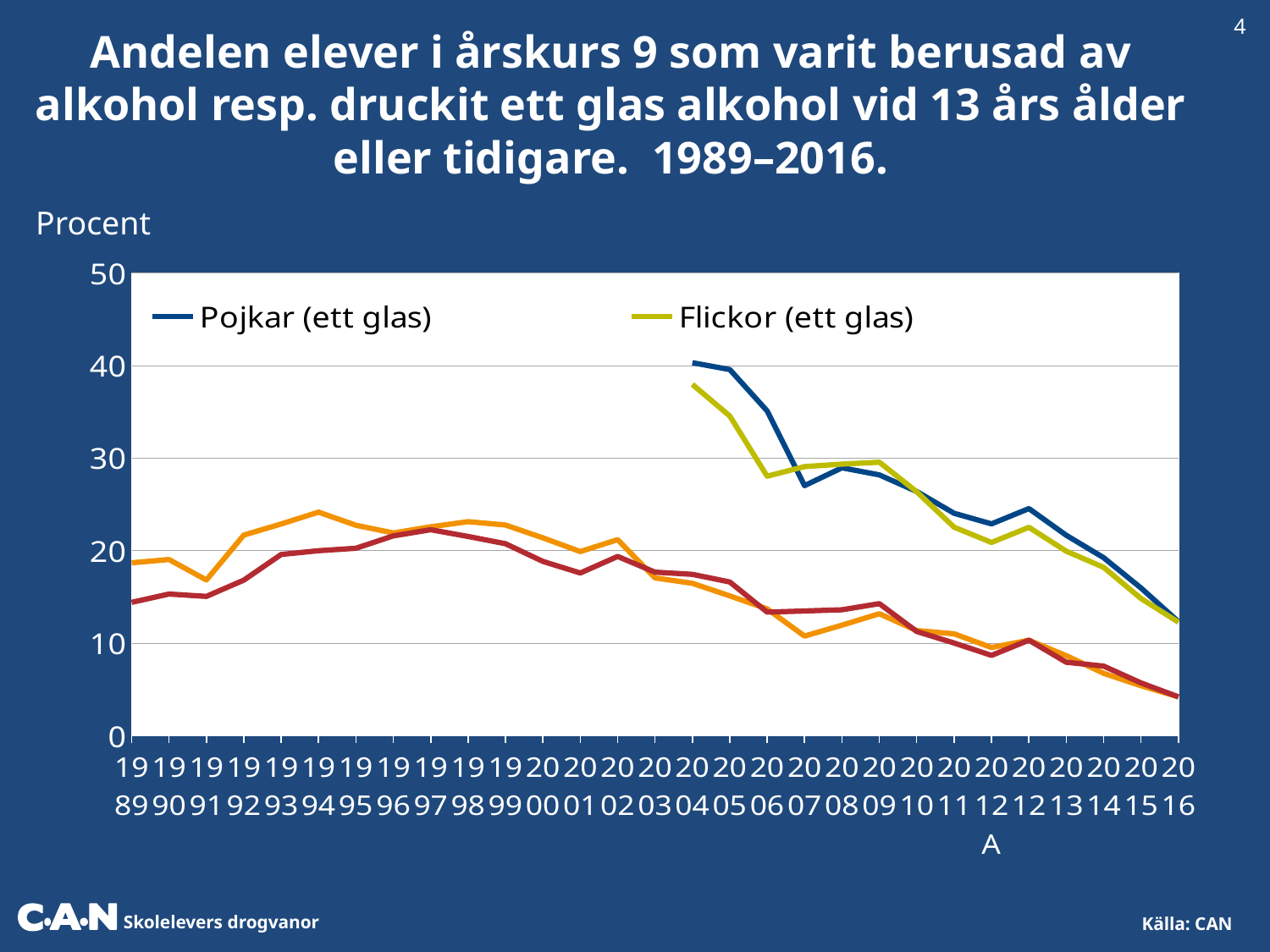
Is the value for Pojkar (ett glas) in 2016 greater or less than 20? less Is the value for Flickor (ett glas) in 2006 greater or less than 30? less Does the Pojkar (ett glas) line rise or fall from 2004 to 2016? fall How many series does the legend list? 2 What kind of chart is shown on the slide? line chart Which two series are named in the legend? Pojkar (ett glas) and Flickor (ett glas) Is the value for Pojkar (ett glas) in 2011 greater or less than 20? greater Does the Flickor (ett glas) line rise or fall from 2004 to 2016? fall What label is shown on the vertical axis? Procent In 2006, which series has the higher value, Pojkar (ett glas) or Flickor (ett glas)? Pojkar (ett glas) In which year does the Pojkar (ett glas) line reach its highest value? 2004